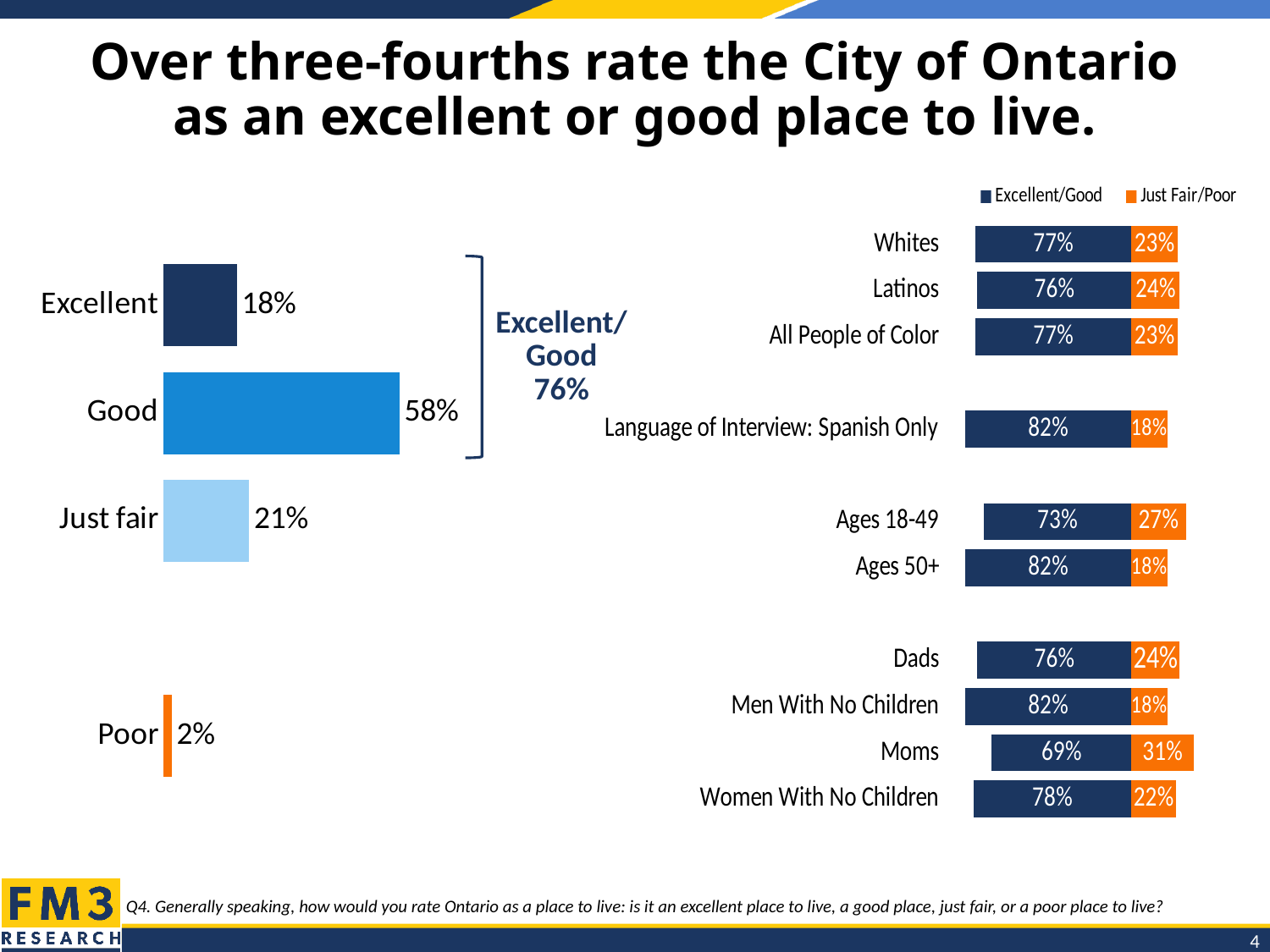
In the right chart, what is the Excellent/Good value for Moms? 69% In the right chart, which group has the lowest Excellent/Good value? Moms In the right chart, which is larger: the Excellent/Good value for Ages 50+ or for Ages 18-49? Ages 50+ How many series does the legend of the right chart list? 2 In the right chart, what is the Just Fair/Poor value for Ages 18-49? 27% What kind of chart is the chart on the right side of the slide? Stacked bar chart In the right chart, what is the total of the stacked bar for Women With No Children? 100% In the left chart, which rating category has the highest value? Good In the left chart, how many rating categories are shown? 4 In the left chart, what is the difference between the Just fair and Excellent percentages? 3% In the left chart, which rating category has the lowest value? Poor In the left chart, what percentage rated Ontario as a good place to live? 58%